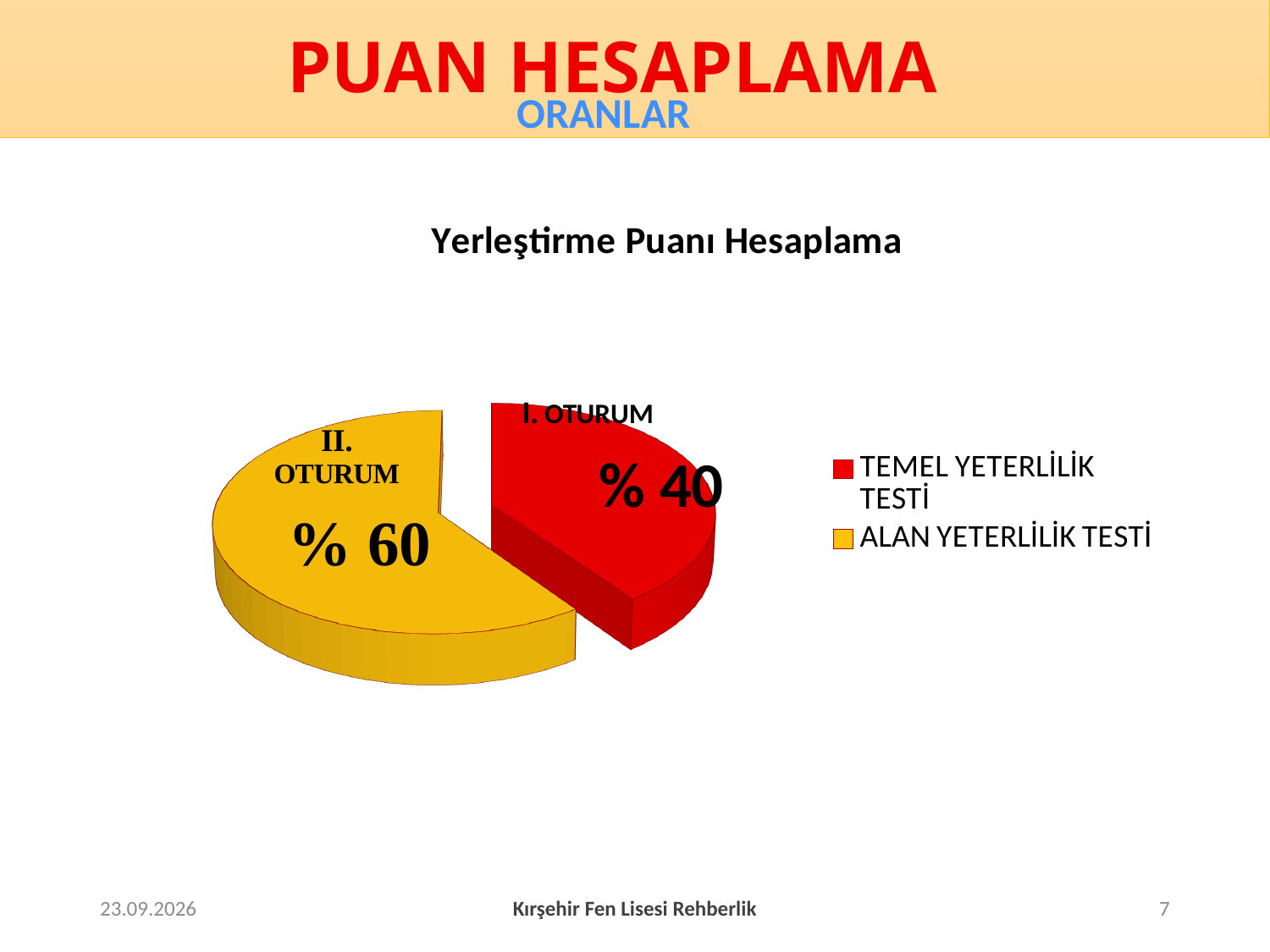
What kind of chart is shown on the slide? pie chart What share of the pie does TEMEL YETERLİLİK TESTİ (I. OTURUM) have? % 40 How many entries does the legend list? 2 How many slices does the pie chart have? 2 Which slice is the largest? ALAN YETERLİLİK TESTİ What is the difference between the II. OTURUM share and the I. OTURUM share? 20 percentage points What colour is the ALAN YETERLİLİK TESTİ slice? yellow What is the chart's title? Yerleştirme Puanı Hesaplama What share of the pie does ALAN YETERLİLİK TESTİ (II. OTURUM) have? % 60 Which is larger, the share for TEMEL YETERLİLİK TESTİ or the share for ALAN YETERLİLİK TESTİ? ALAN YETERLİLİK TESTİ Is the share for I. OTURUM greater or less than 50%? less Which slice is the smallest? TEMEL YETERLİLİK TESTİ